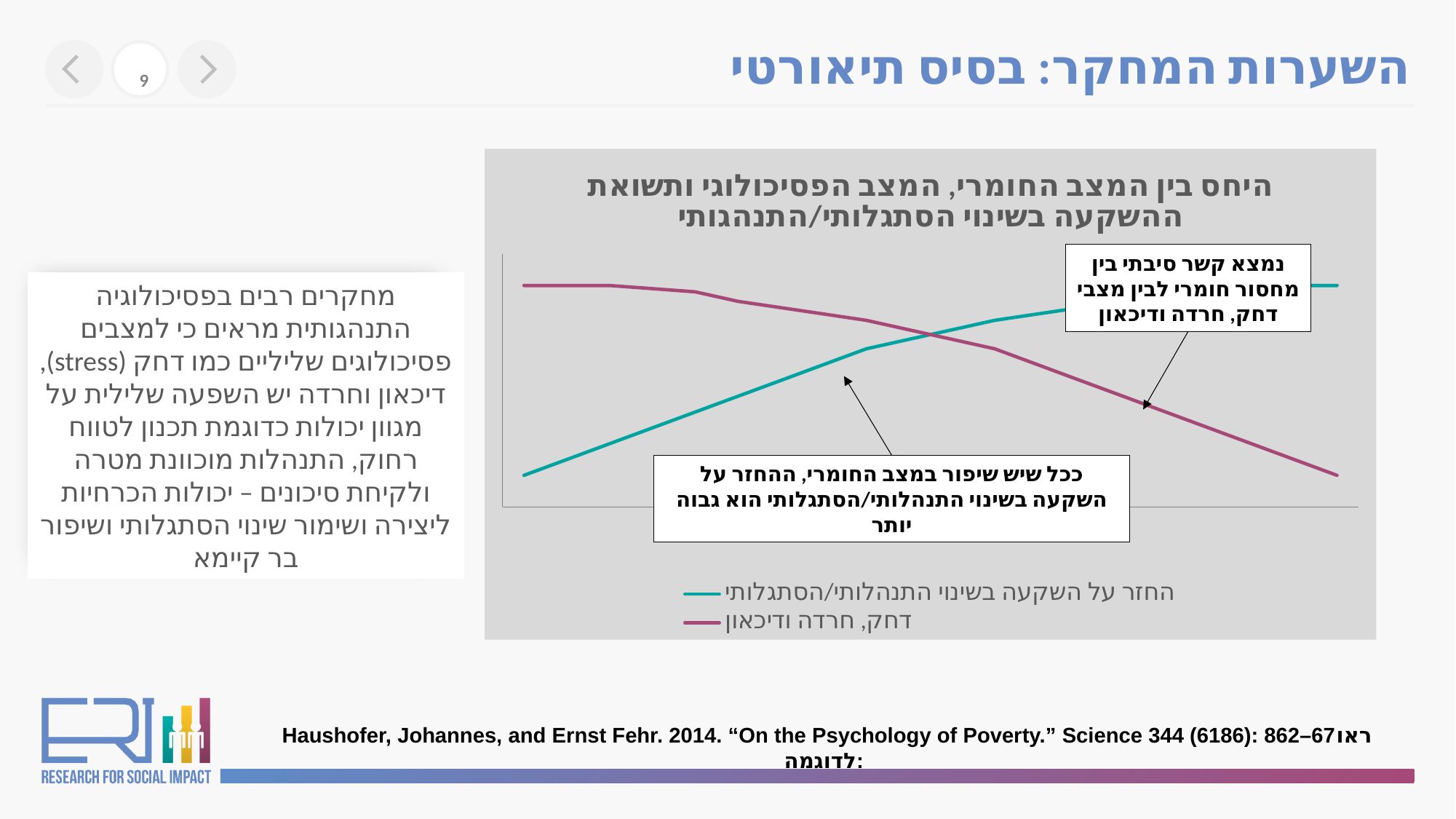
How many series does the chart's legend list? 2 What kind of chart is shown on the slide? Line chart Which series is drawn in teal (green-blue)? החזר על השקעה בשינוי התנהלותי/הסתגלותי Does the line for "דחק, חרדה ודיכאון" rise or fall from left to right? Falls What is the title of the chart? היחס בין המצב החומרי, המצב הפסיכולוגי ותשואת ההשקעה בשינוי הסתגלותי/התנהגותי Does the line for "החזר על השקעה בשינוי התנהלותי/הסתגלותי" rise or fall from left to right? Rises